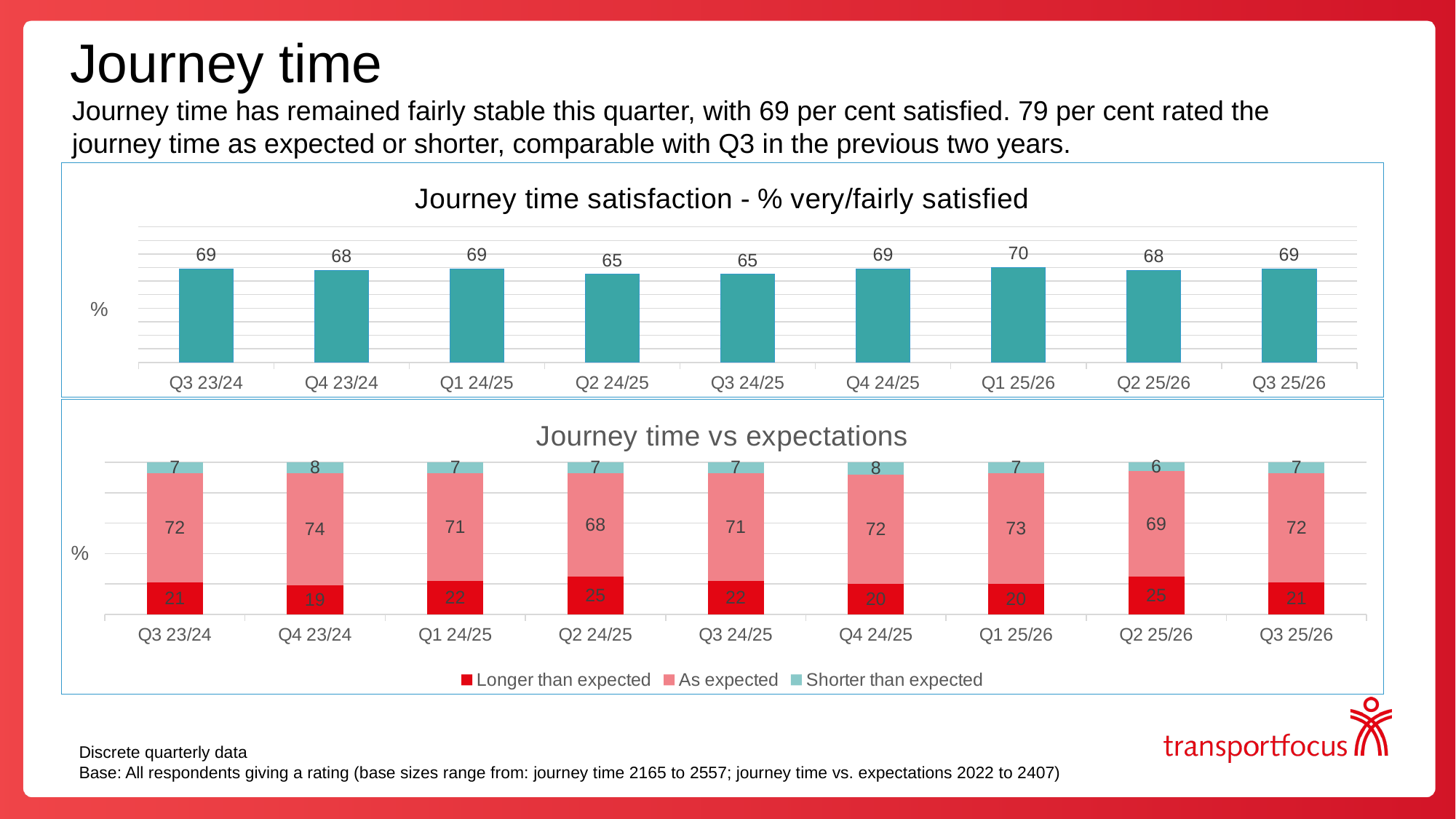
In the 'Journey time vs expectations' chart, is the 'Longer than expected' value larger for Q2 24/25 or Q4 23/24? Q2 24/25 In the 'Journey time satisfaction - % very/fairly satisfied' chart, which quarter has the highest value? Q1 25/26 In the 'Journey time satisfaction - % very/fairly satisfied' chart, what is the value for Q3 25/26? 69 In the 'Journey time vs expectations' chart, what is the 'Longer than expected' value for Q2 25/26? 25 In the 'Journey time vs expectations' chart, what is the total of the stacked bar for Q3 25/26? 100 In the 'Journey time vs expectations' chart, what is the 'As expected' value for Q4 23/24? 74 In the 'Journey time vs expectations' chart, which quarter has the lowest 'Shorter than expected' value? Q2 25/26 What kind of chart is 'Journey time satisfaction - % very/fairly satisfied'? Bar chart In the 'Journey time vs expectations' chart, which series is shown in bright red? Longer than expected In the 'Journey time satisfaction - % very/fairly satisfied' chart, what is the difference between Q1 25/26 and Q2 24/25? 5 In the 'Journey time satisfaction - % very/fairly satisfied' chart, how many quarters are plotted? 9 In the 'Journey time vs expectations' chart, how many series does the legend list? 3